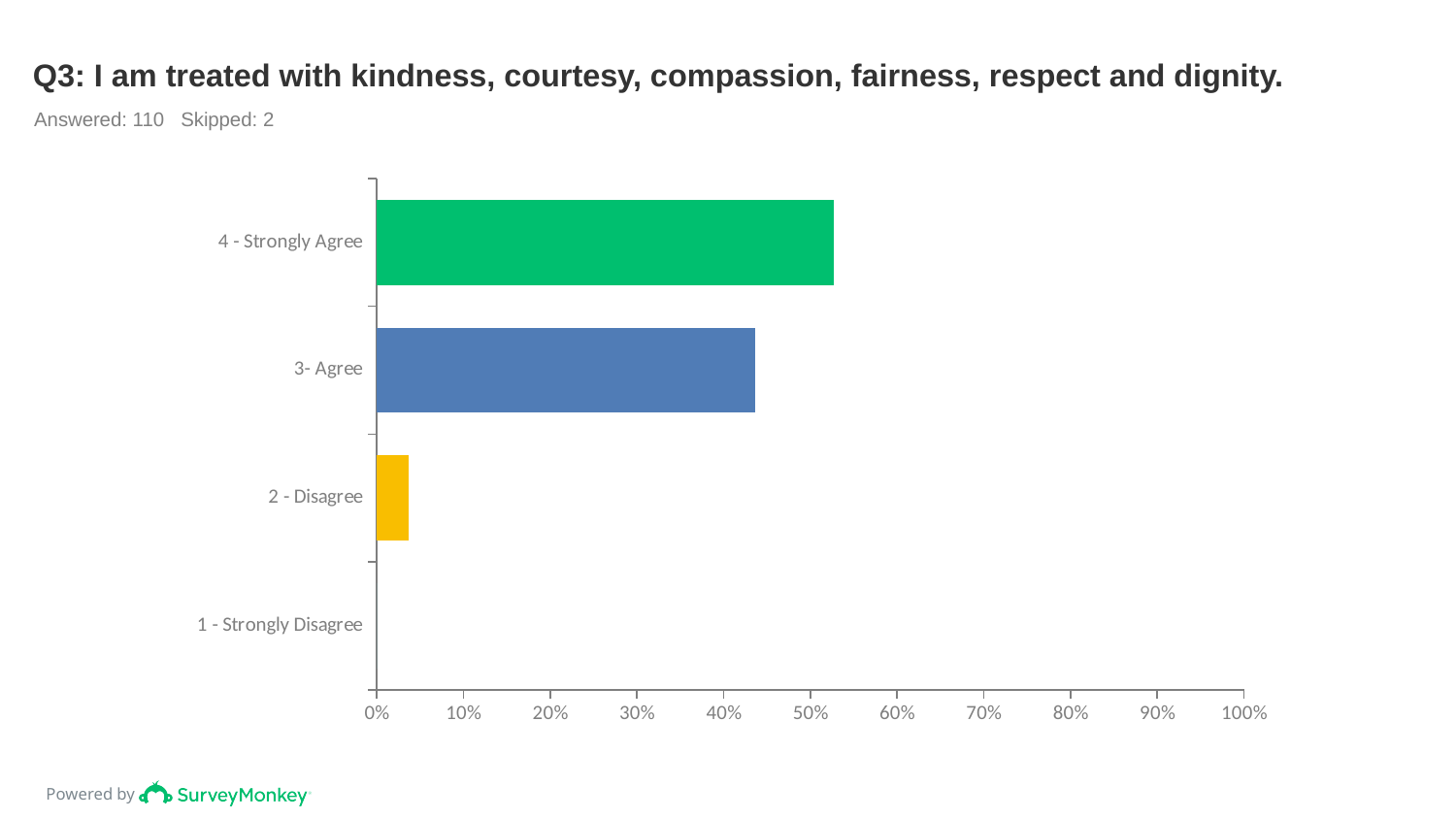
Which category has the lowest value? 1 - Strongly Disagree What kind of chart is shown on the slide? bar chart Is the value for 3- Agree greater or less than 40%? greater How many categories are plotted on the chart? 4 Which category has the highest value? 4 - Strongly Agree How many respondents answered the question according to the slide? 110 What is the title of the chart? Q3: I am treated with kindness, courtesy, compassion, fairness, respect and dignity. Which is larger, the value for 4 - Strongly Agree or the value for 3- Agree? 4 - Strongly Agree Is the value for 4 - Strongly Agree greater or less than 50%? greater Is the value for 3- Agree greater or less than 50%? less Which is larger, the value for 2 - Disagree or the value for 3- Agree? 3- Agree